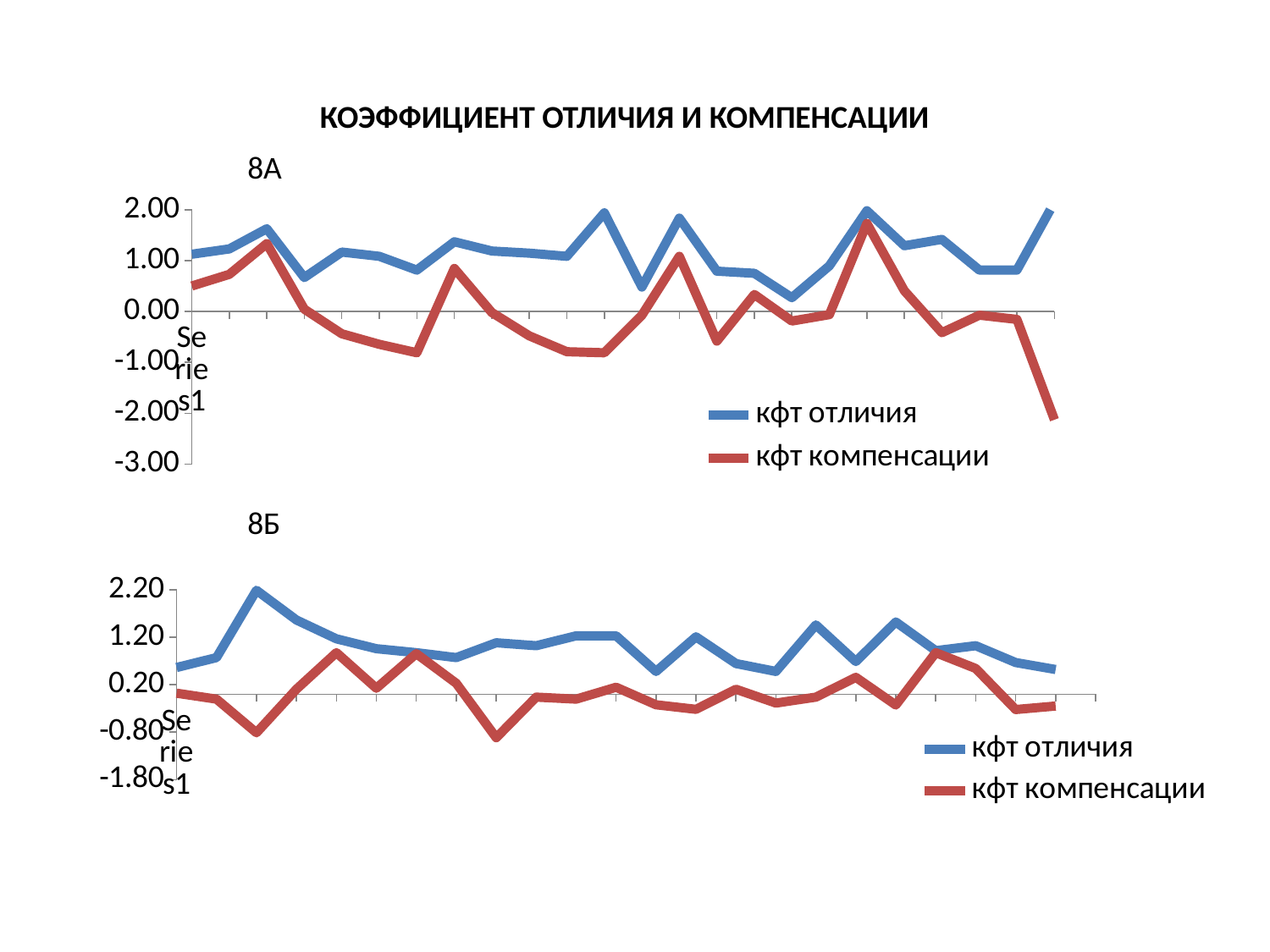
What kind of chart is the chart titled 8Б? line chart In the chart titled 8Б, is the lowest value of the кфт компенсации line greater or less than 0.20? less In the chart titled 8А, is the last point of the кфт компенсации line greater or less than -1.00? less In the chart titled 8Б, which series reaches the highest value on the chart? кфт отличия What is the title of the slide above the two charts? КОЭФФИЦИЕНТ ОТЛИЧИЯ И КОМПЕНСАЦИИ In the chart titled 8А, which series is drawn in red? кфт компенсации In the chart titled 8Б, is the highest value of the кфт отличия line greater or less than 1.20? greater How many series does the legend of the chart titled 8А list? 2 In the chart titled 8А, which series reaches the lowest value on the chart? кфт компенсации How many series does the legend of the chart titled 8Б list? 2 What kind of chart is the chart titled 8А? line chart